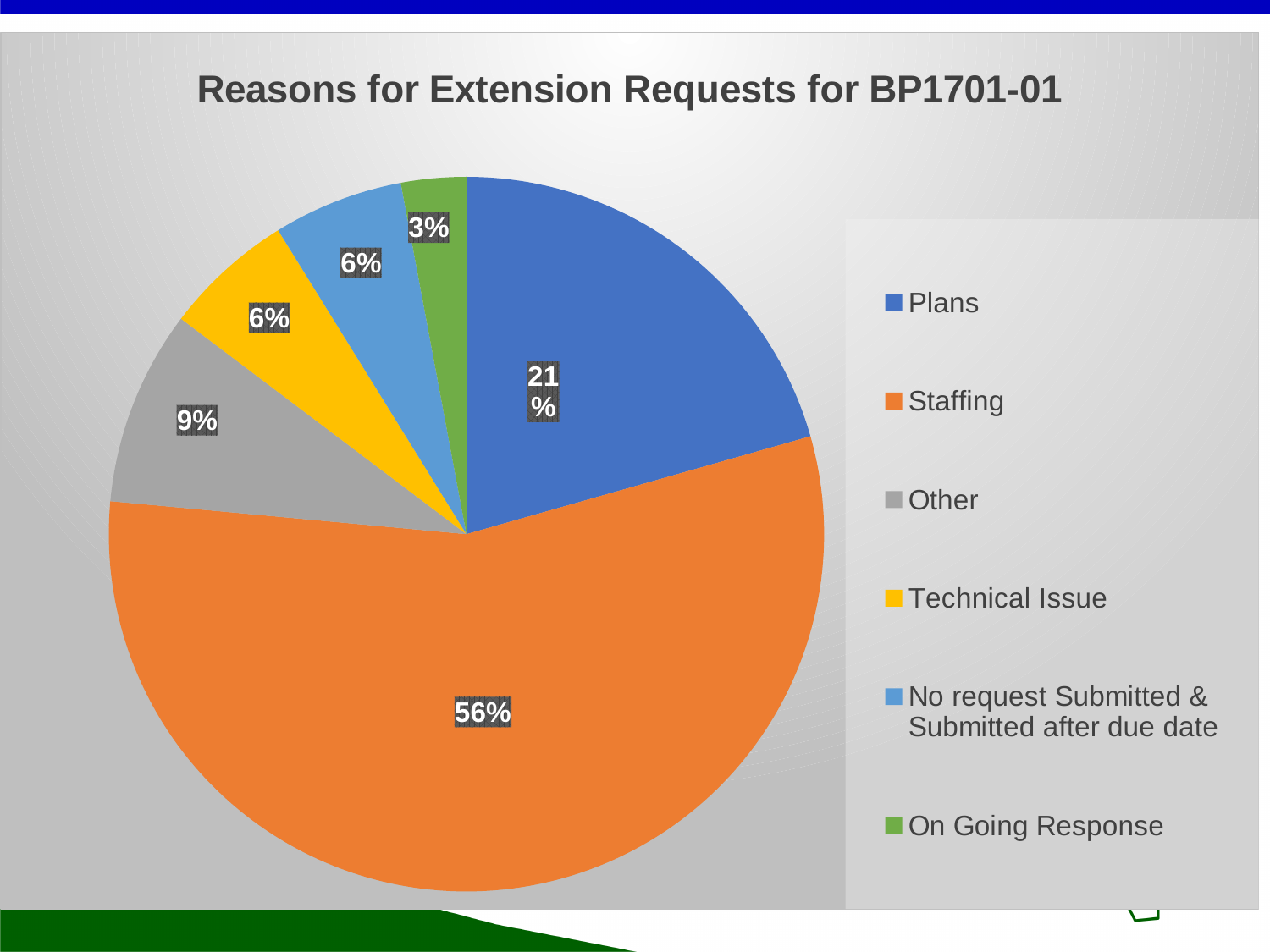
How many percentage points larger is the Staffing share than the Plans share? 35 Which reason accounts for the largest share of extension requests? Staffing How many reasons (slices) are shown in the pie chart? 6 What type of chart is shown on the slide? Pie chart Which is larger, the share for Plans or the share for Other? Plans What share of extension requests is attributed to On Going Response? 3% What is the title of the chart? Reasons for Extension Requests for BP1701-01 What share of extension requests is attributed to Plans? 21% What share of extension requests is attributed to Staffing? 56% What share of extension requests is attributed to Technical Issue? 6% Which reason accounts for the smallest share of extension requests? On Going Response What share of extension requests is attributed to Other? 9%